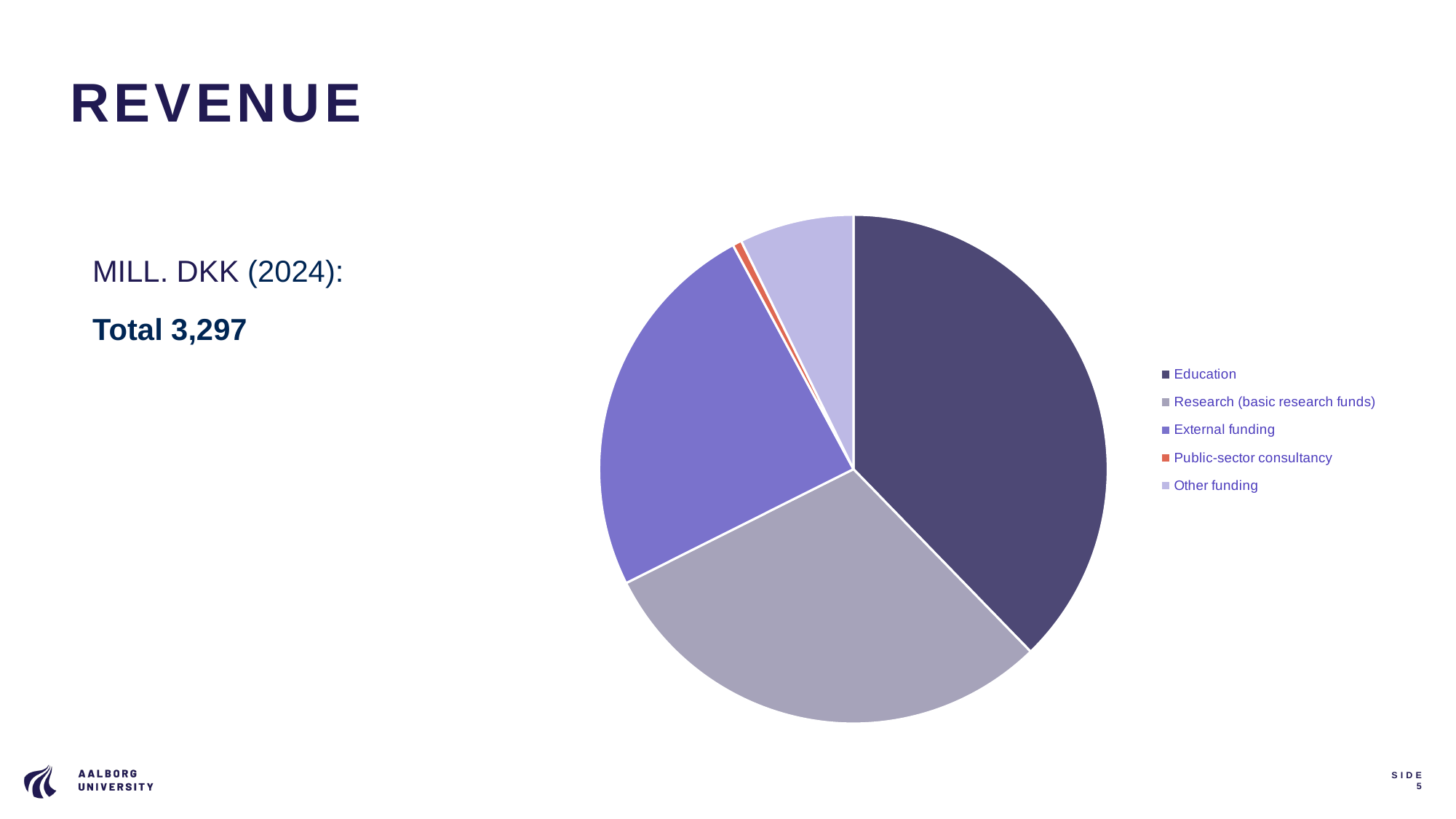
Which slice is larger, External funding or Public-sector consultancy? External funding Which slice is larger, Research (basic research funds) or External funding? Research (basic research funds) Which legend entry is shown in red/orange? Public-sector consultancy Which category has the largest slice of the pie chart? Education What total revenue in mill. DKK is stated on the slide for 2024? 3,297 What kind of chart is shown on the slide? pie chart How many slices does the pie chart have? 5 Which category has the smallest slice of the pie chart? Public-sector consultancy What is the title of the slide containing the pie chart? REVENUE Which slice is larger, Education or Other funding? Education How many entries does the legend list? 5